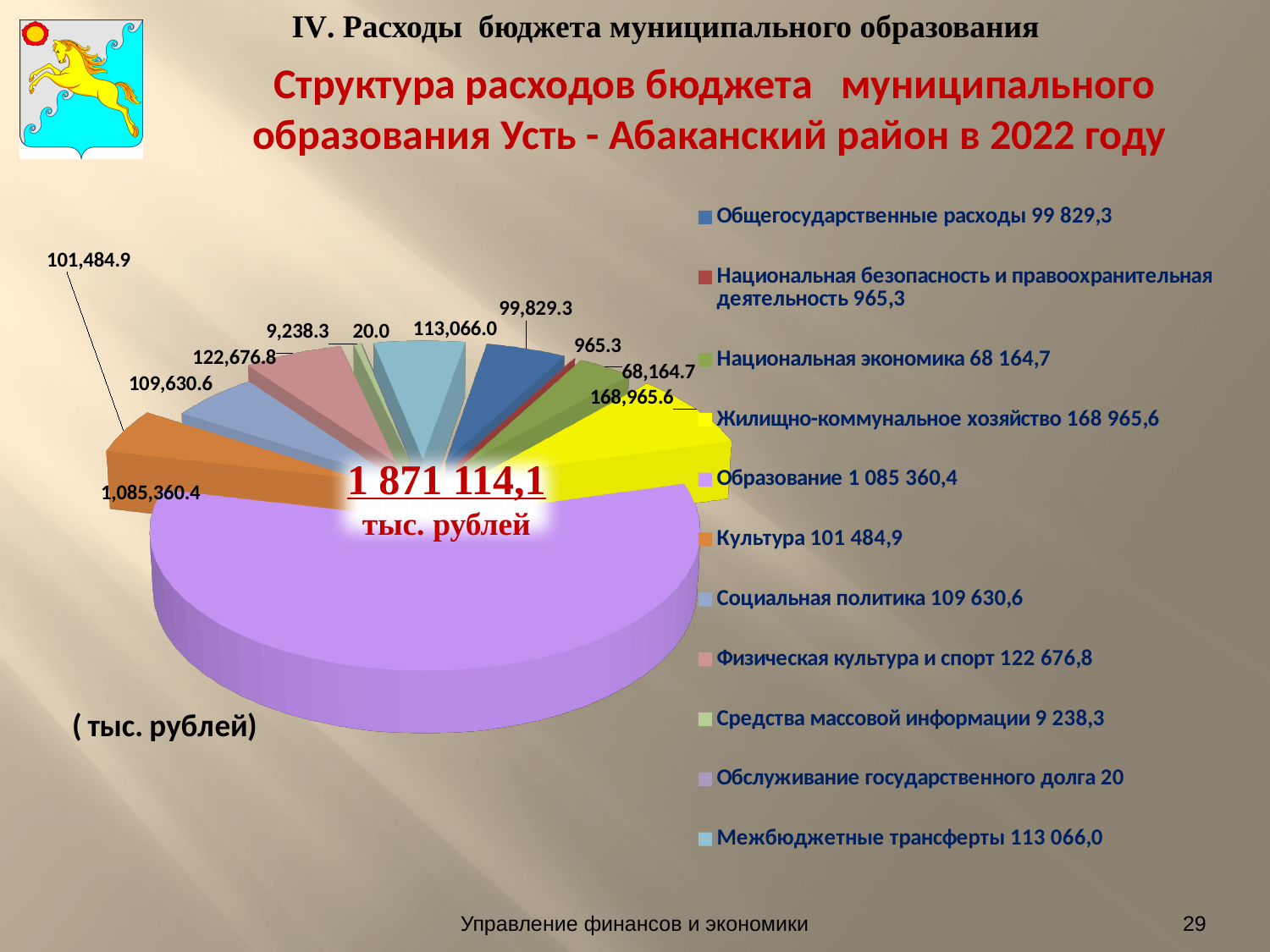
Which category has the smallest value on the pie chart? Обслуживание государственного долга Which category has the largest slice of the pie? Образование How many categories (slices) does the pie chart have? 11 What type of chart is shown on the slide? Pie chart What is the value for Жилищно-коммунальное хозяйство? 168,965.6 In what units are the values on the chart given? тыс. рублей What is the value for Обслуживание государственного долга? 20.0 Which is larger: Социальная политика or Культура? Социальная политика What is the value for Межбюджетные трансферты? 113,066.0 What is the difference between Жилищно-коммунальное хозяйство and Общегосударственные расходы? 69,136.3 What is the value for Образование on the pie chart? 1,085,360.4 What total amount is printed in the centre of the pie chart? 1 871 114,1 тыс. рублей